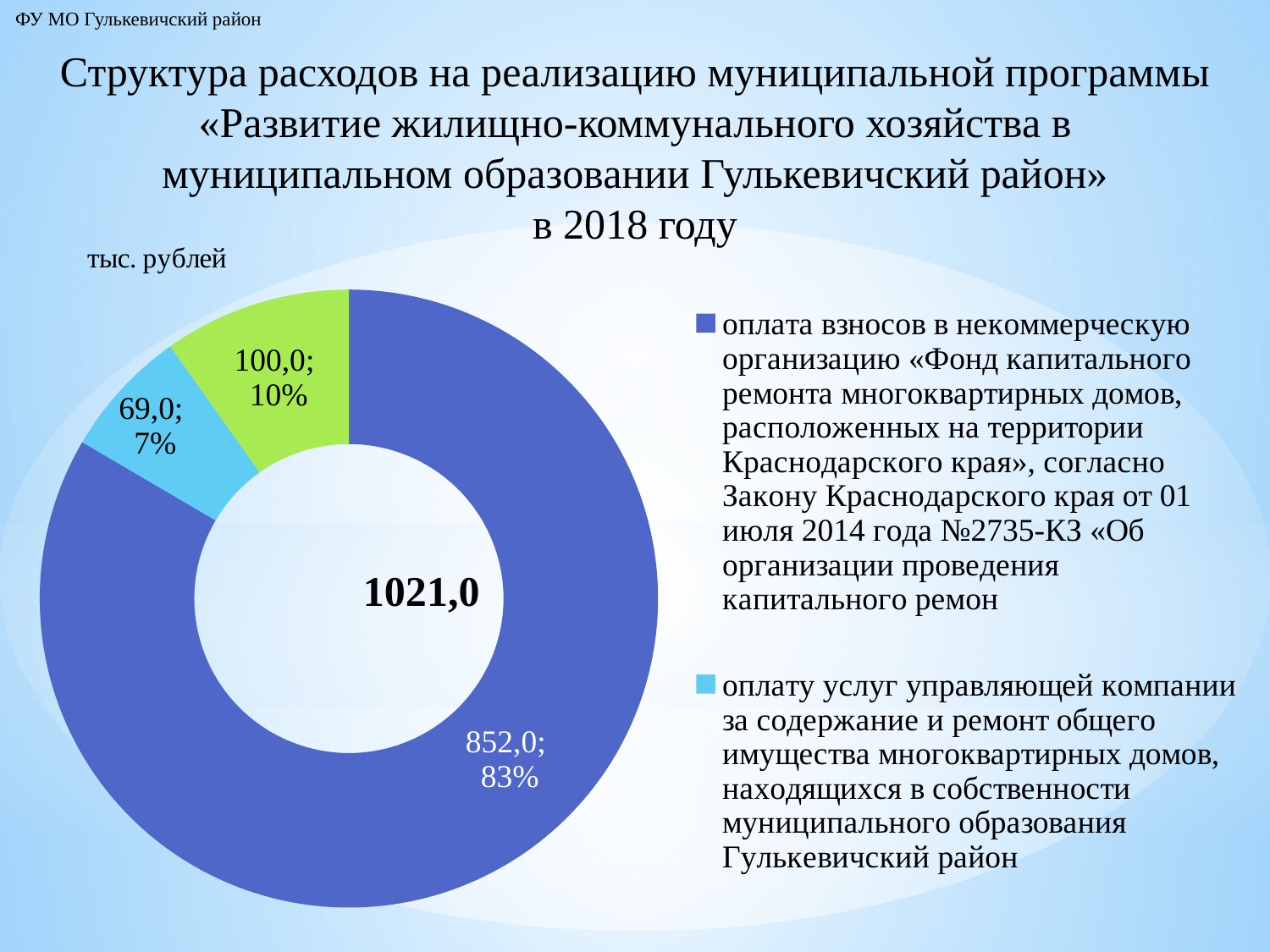
What share of the total does the slice «оплата взносов в некоммерческую организацию «Фонд капитального ремонта...»» represent? 83% How many entries does the legend list? 2 Which legend category has the largest slice in the chart? оплата взносов в некоммерческую организацию «Фонд капитального ремонта многоквартирных домов...» Which legend category has the smallest slice in the chart? оплату услуг управляющей компании за содержание и ремонт общего имущества многоквартирных домов... How many slices does the chart have? 3 What value is shown for the slice «оплату услуг управляющей компании за содержание и ремонт общего имущества многоквартирных домов...»? 69,0 What value is shown for the slice «оплата взносов в некоммерческую организацию «Фонд капитального ремонта многоквартирных домов...»»? 852,0 What share of the total does the slice «оплату услуг управляющей компании...» represent? 7% What is the difference between the value for «оплата взносов в некоммерческую организацию «Фонд капитального ремонта...»» (852,0) and the value for «оплату услуг управляющей компании...» (69,0)? 783,0 In what units are the chart values given, according to the label above the chart? тыс. рублей What kind of chart is shown on the slide? Doughnut (pie) chart What total value is shown in the centre of the chart? 1021,0